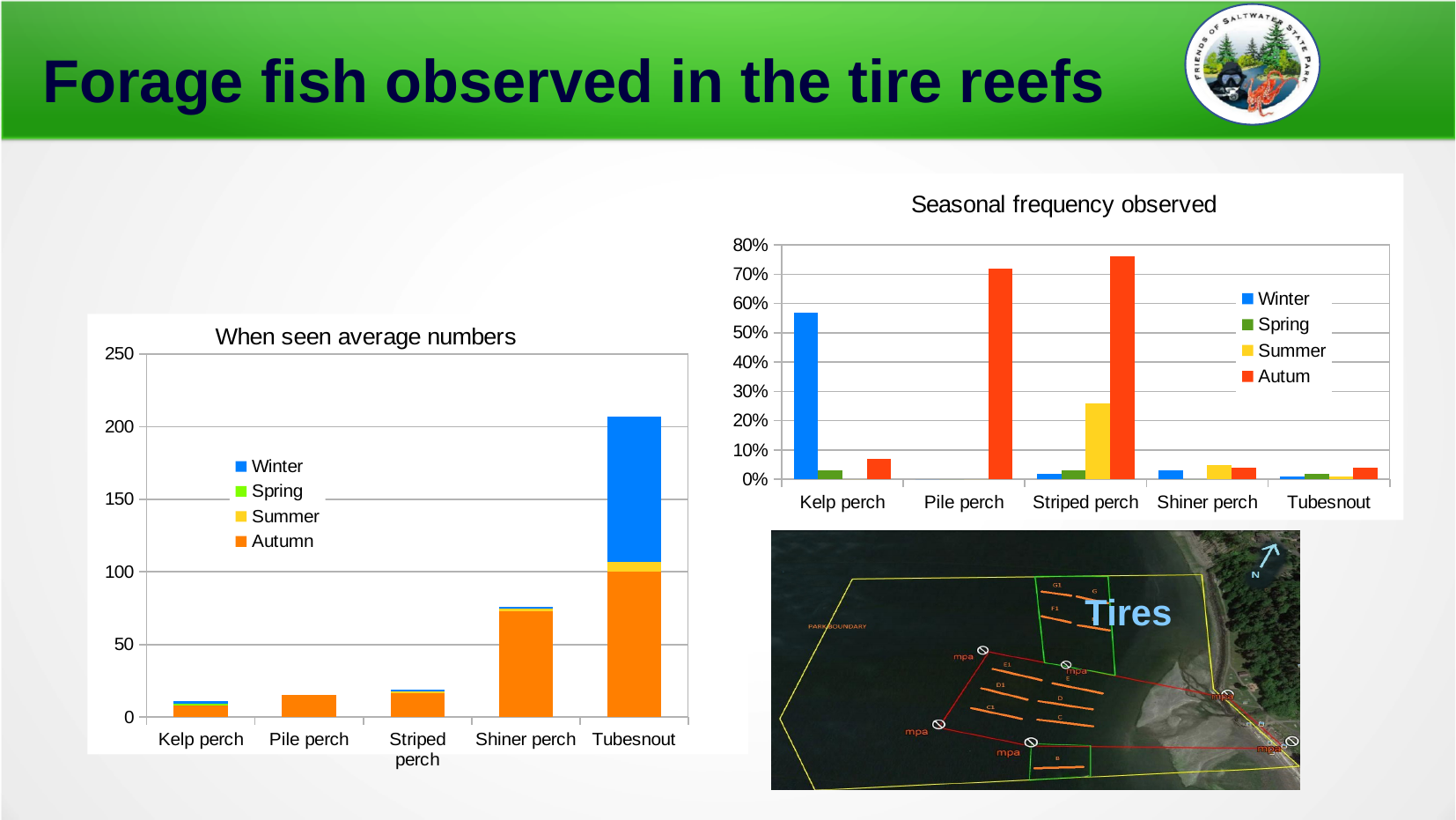
How many fish categories are shown on the x axis of the "When seen average numbers" chart? 5 In the "When seen average numbers" chart, is the total for Tubesnout greater or less than 150? greater In the "Seasonal frequency observed" chart, which season has the highest bar for Kelp perch? Winter What is the title of the chart in the upper right of the slide? Seasonal frequency observed In the "When seen average numbers" chart, is the total for Shiner perch greater or less than 100? less How many series does the legend of the "Seasonal frequency observed" chart list? 4 In the "When seen average numbers" chart, which is larger, the total for Shiner perch or the total for Striped perch? Shiner perch In the "Seasonal frequency observed" chart, is the Winter value for Kelp perch greater or less than 50%? greater How many series does the legend of the "When seen average numbers" chart list? 4 In the "When seen average numbers" chart, which fish has the tallest stacked bar? Tubesnout What type of chart is the "When seen average numbers" chart? bar chart